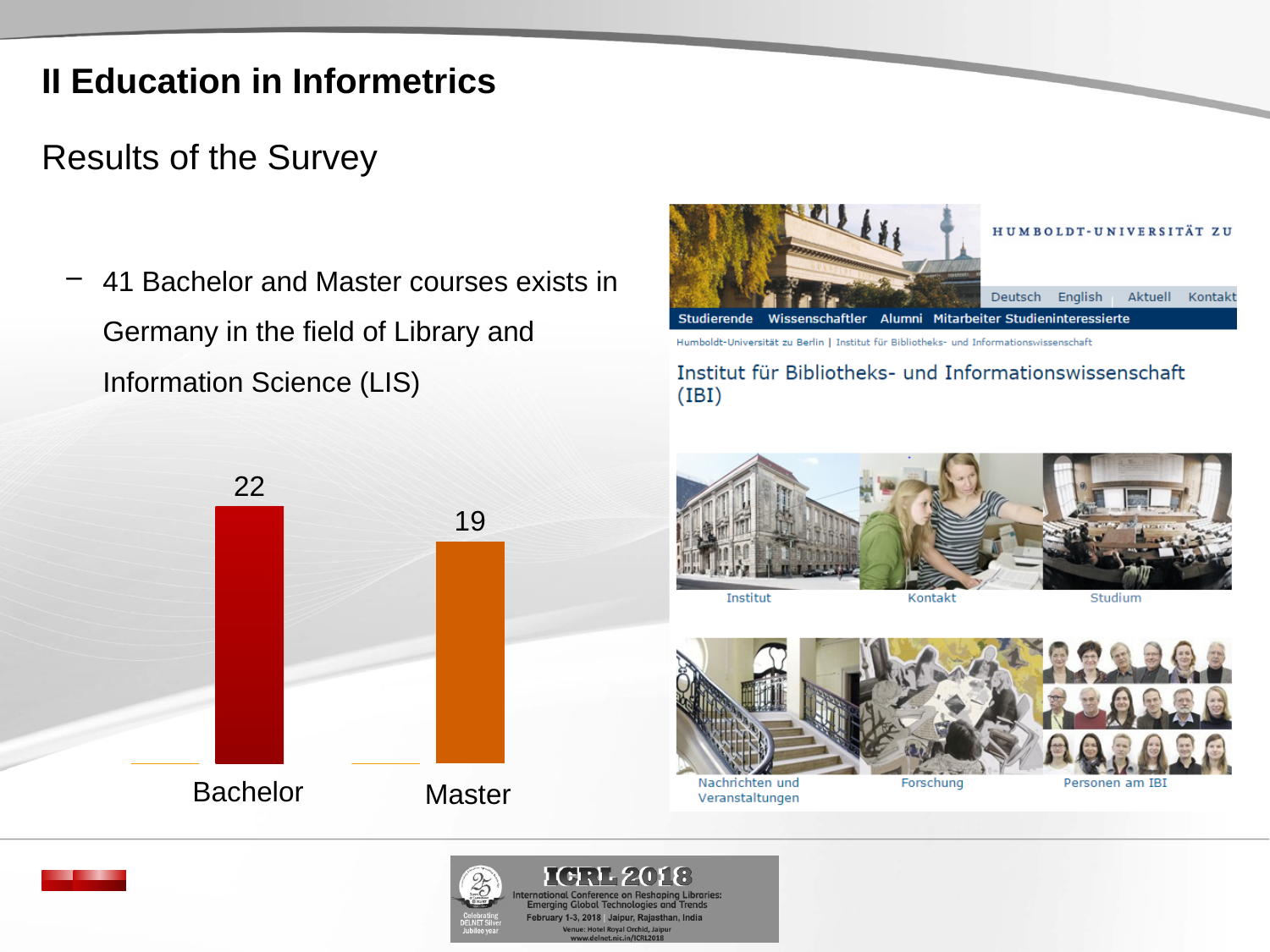
Which is larger, the value for Bachelor or the value for Master? Bachelor What is the difference between the Bachelor and Master values? 3 Which category has the lowest value in the bar chart? Master What is the value for Bachelor in the bar chart? 22 What colour is the Master bar in the chart? orange Which category has the highest value in the bar chart? Bachelor How many categories are shown in the bar chart? 2 What is the value for Master in the bar chart? 19 What colour is the Bachelor bar in the chart? red What is the total of the Bachelor and Master values in the chart? 41 What kind of chart is shown on the slide? bar chart